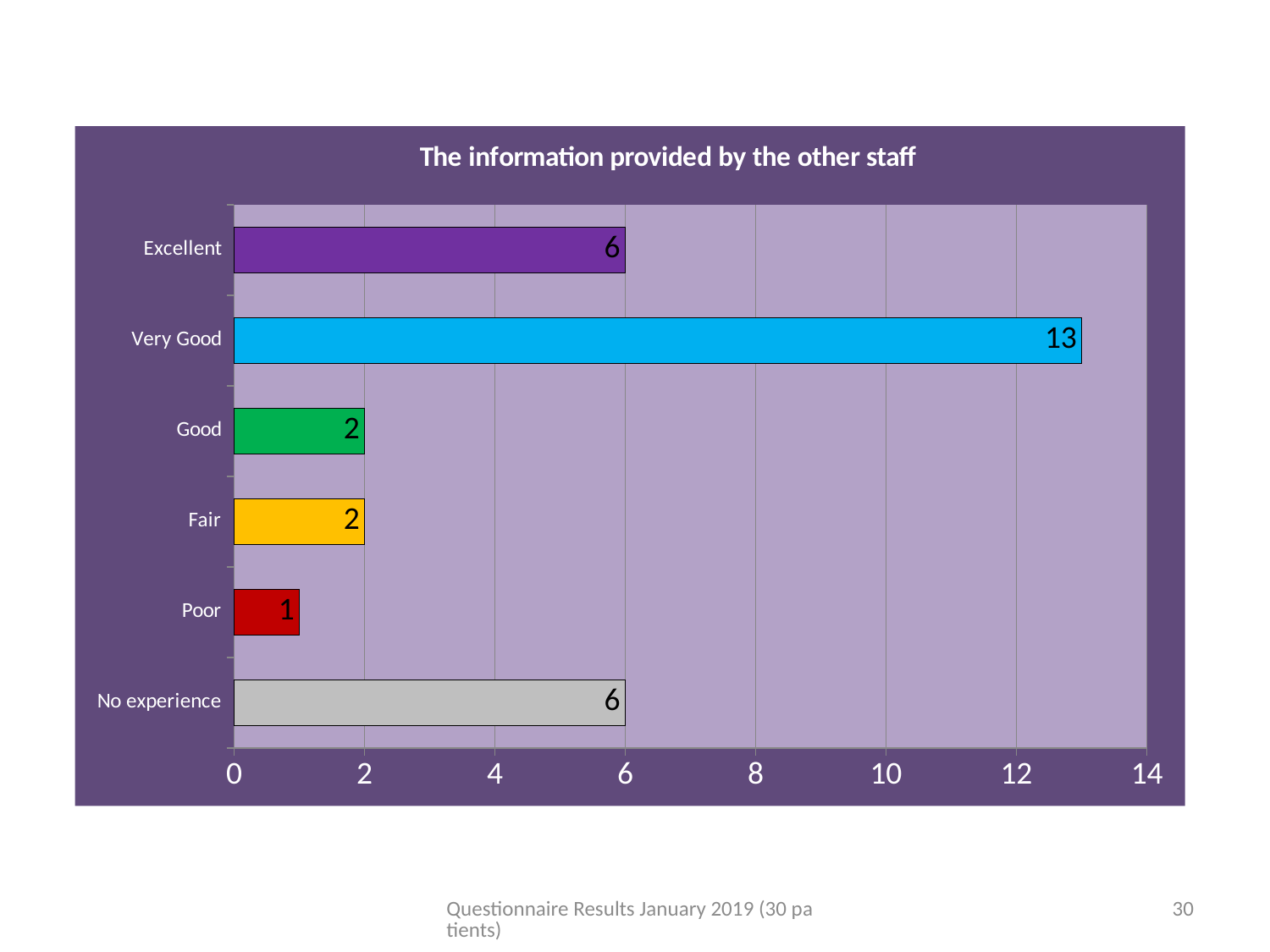
How many categories are shown in the chart? 6 Which category has the highest value? Very Good Which category has the lowest value? Poor What is the value for Poor? 1 What is the value for No experience? 6 Is the value for Very Good greater or less than 12? greater What is the title of the chart? The information provided by the other staff What kind of chart is shown on the slide? bar chart What is the value for Very Good? 13 What is the difference between the values for Very Good and Excellent? 7 Which is larger, the value for Excellent or the value for Good? Excellent What colour is the bar for Poor? red